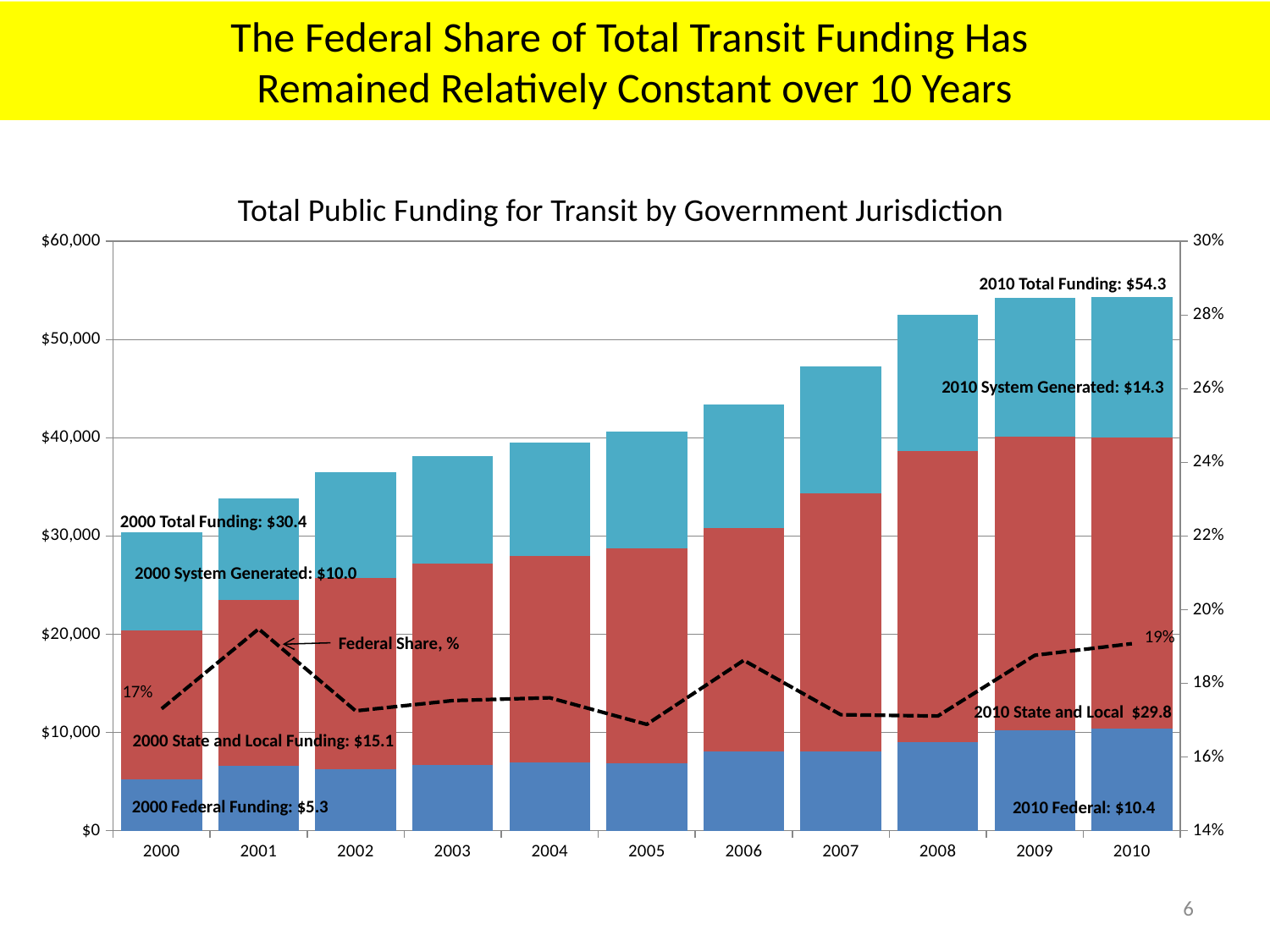
What was the 2010 Federal funding according to the data label? $10.4 What was the 2010 System Generated funding? $14.3 What was the 2000 State and Local Funding? $15.1 How many years are shown on the x axis? 11 What was the Federal Share percentage in 2000? 17% What kind of chart is used to show the funding by jurisdiction? Stacked bar chart with a line overlay What was the 2000 Total Funding according to the data label? $30.4 Does total funding generally rise or fall from 2000 to 2010? rise By how much did Total Funding increase from 2000 ($30.4) to 2010 ($54.3)? $23.9 Is the total funding bar for 2008 greater or less than $50,000? greater What is the title of the chart? Total Public Funding for Transit by Government Jurisdiction Which year has the lowest total funding bar? 2000